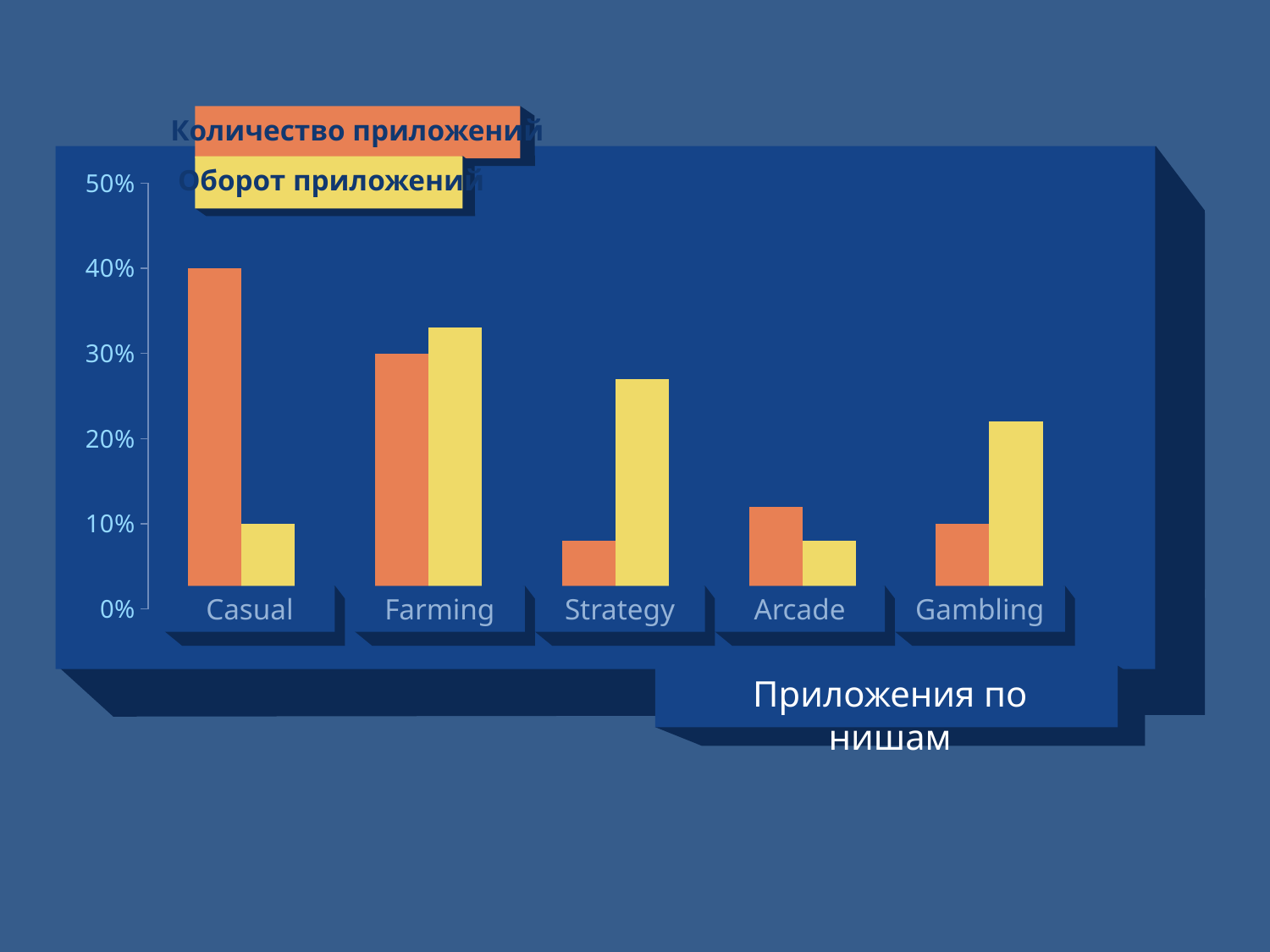
For Casual, which series has the larger value: 'Количество приложений' or 'Оборот приложений'? Количество приложений What kind of chart is shown on the slide? bar chart Is the value of 'Количество приложений' for Arcade greater or less than 20%? less Is the value of 'Оборот приложений' for Strategy greater or less than 20%? greater Which category has the lowest value for 'Оборот приложений'? Arcade Which category has the highest value for 'Оборот приложений'? Farming How many series does the legend list? 2 Which category has the highest value for 'Количество приложений'? Casual What is the title of the chart? Приложения по нишам How many categories are shown on the x axis of the chart? 5 Which colour represents the series 'Оборот приложений'? yellow For Gambling, which series has the larger value: 'Количество приложений' or 'Оборот приложений'? Оборот приложений